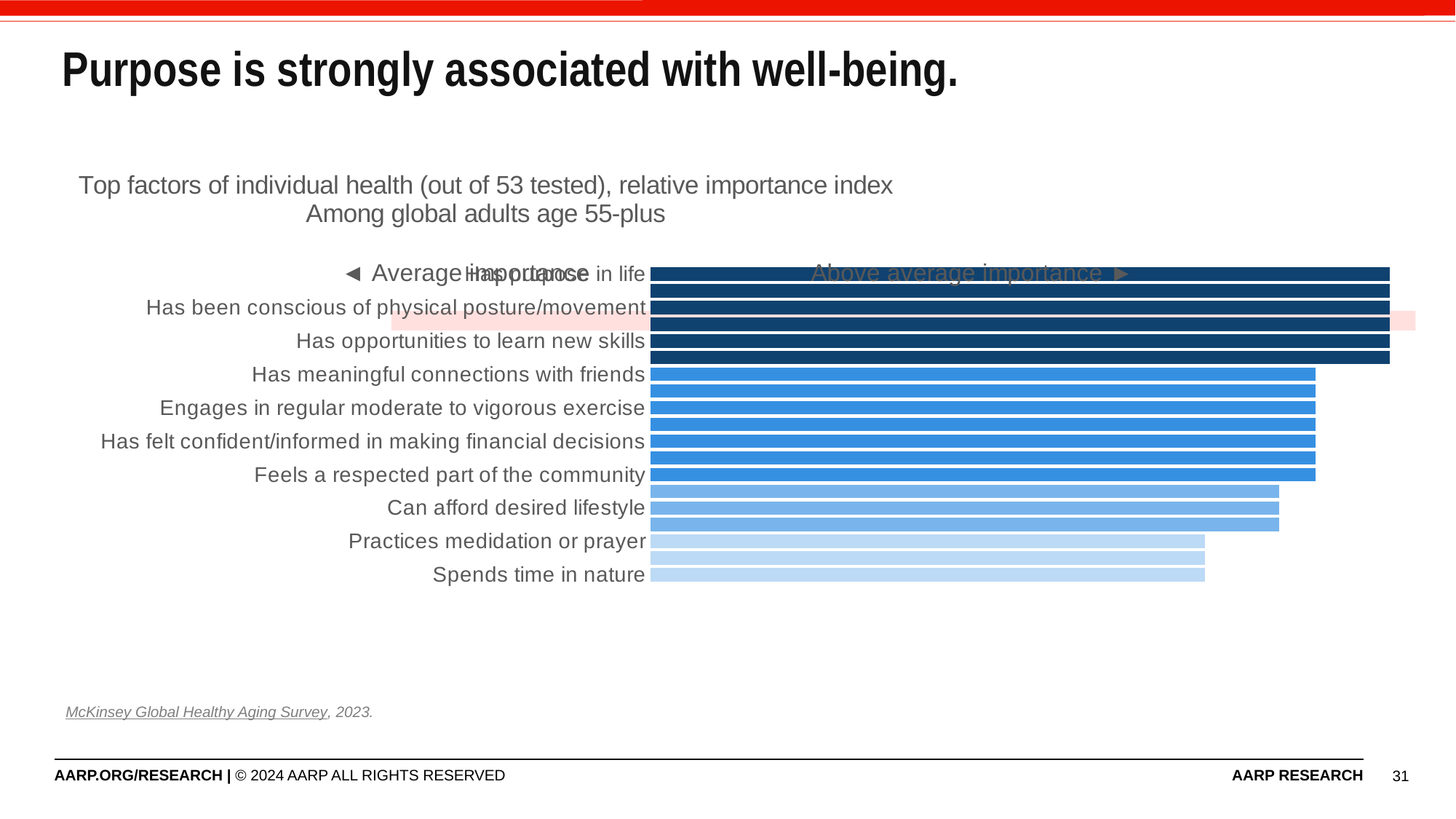
What is the source cited for the chart? McKinsey Global Healthy Aging Survey, 2023 Which has the larger value, 'Engages in regular moderate to vigorous exercise' or 'Spends time in nature'? Engages in regular moderate to vigorous exercise Which has the larger value, 'Has been conscious of physical posture/movement' or 'Practices medidation or prayer'? Has been conscious of physical posture/movement What kind of chart is shown on the slide? bar chart Which has the larger relative importance value, 'Has purpose in life' or 'Spends time in nature'? Has purpose in life Do the bar lengths increase or decrease going from the top category to the bottom category? decrease What is the title of the slide? Purpose is strongly associated with well-being.